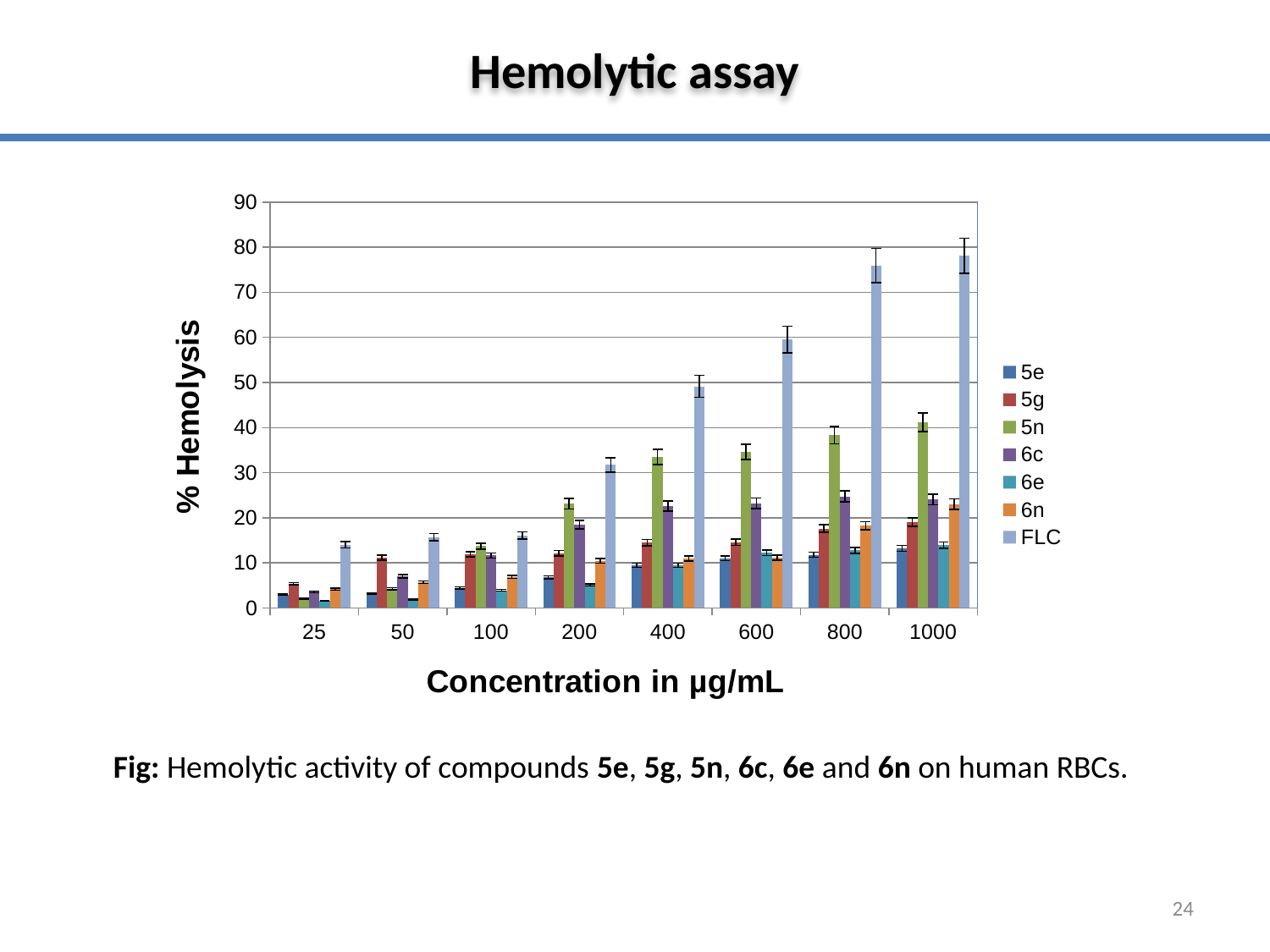
Is the value for FLC at 600 µg/mL greater or less than 50? greater Which series has the highest % Hemolysis at 600 µg/mL? FLC At 1000 µg/mL, which is larger: the value for 5n or the value for 5g? 5n Does the % Hemolysis for FLC rise or fall as concentration increases along the x axis? rise What kind of chart is shown on the slide? bar chart Which series has the highest % Hemolysis at 1000 µg/mL? FLC Is the value for FLC at 1000 µg/mL greater or less than 70? greater Is the value for 5e at 25 µg/mL greater or less than 10? less What is the title of the y axis? % Hemolysis How many series does the legend list? 7 How many concentration categories are shown on the x axis? 8